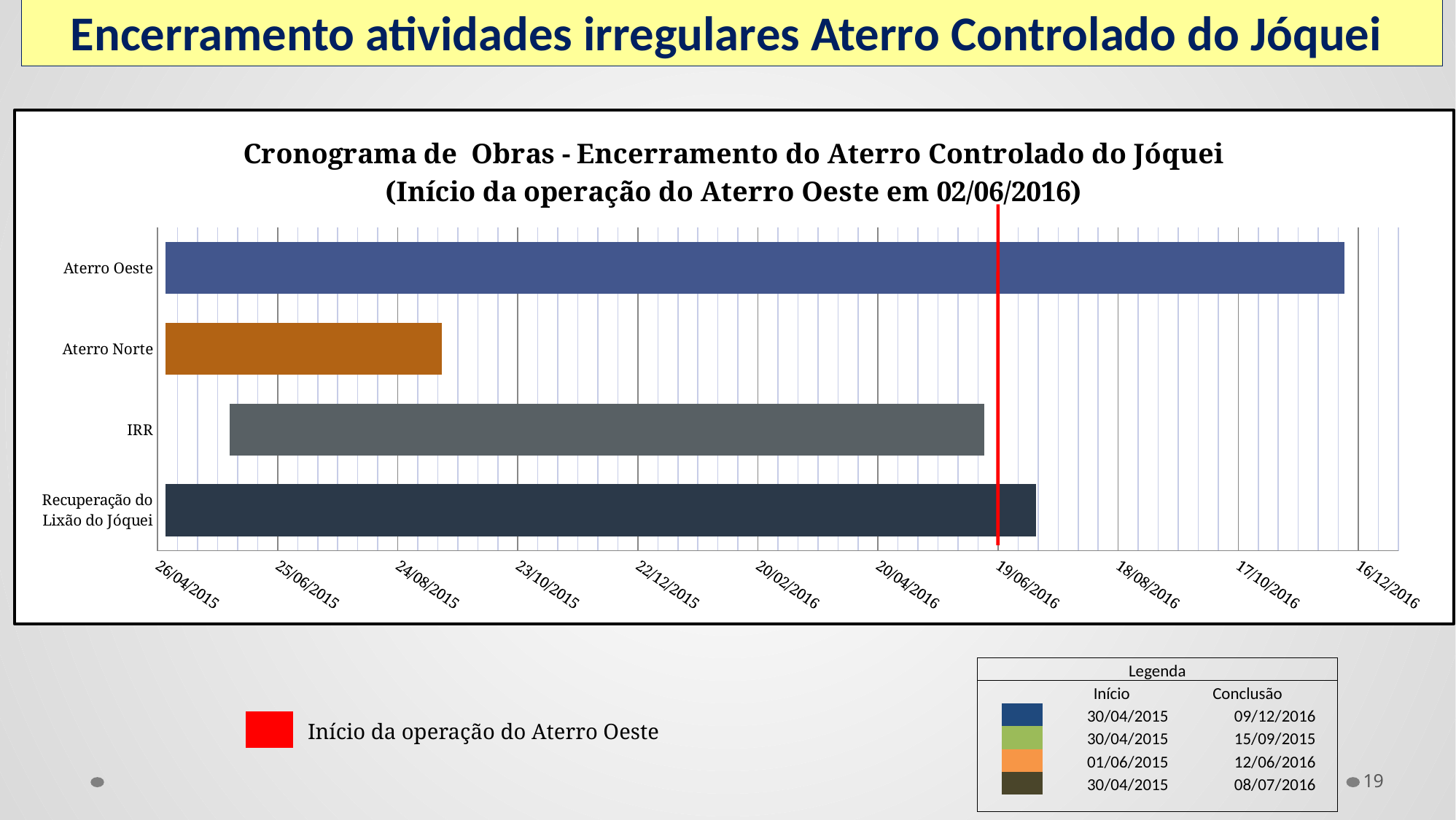
Which activity has the shortest bar in the chart? Aterro Norte Which activity has the longest bar in the chart? Aterro Oeste What is the first date shown on the x axis of the chart? 26/04/2015 Does the Aterro Oeste bar end before or after 17/10/2016? after Which bar is longer, IRR or Aterro Norte? IRR Which bar is longer, Aterro Oeste or Recuperação do Lixão do Jóquei? Aterro Oeste Does the IRR bar end before or after 19/06/2016? before According to the chart title, on what date does the operation of Aterro Oeste begin? 02/06/2016 Does the Aterro Norte bar end before or after 23/10/2015? before Which activity starts latest on the timeline? IRR What kind of chart is shown on the slide? Bar chart How many activities (bars) are plotted in the chart? 4